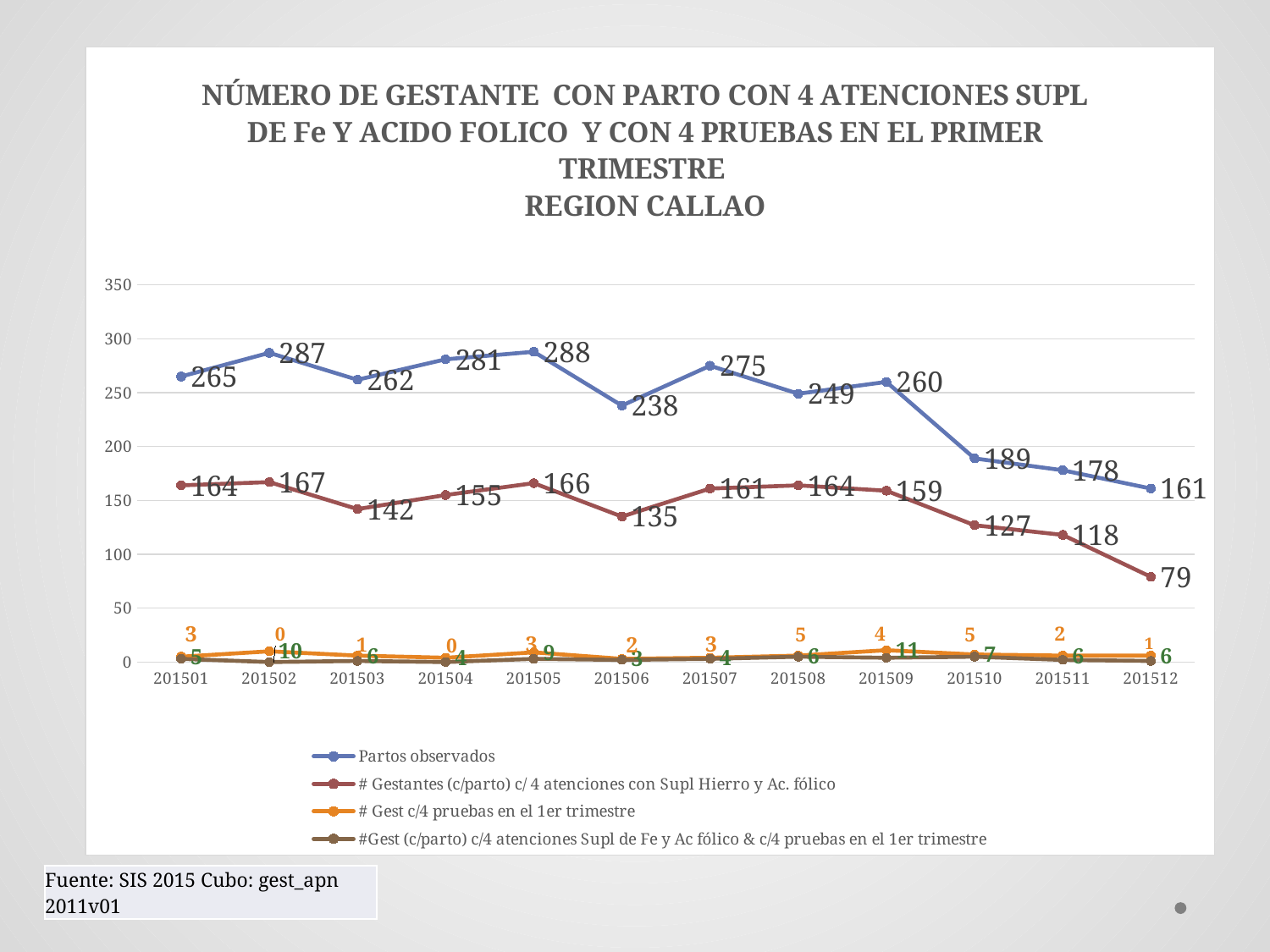
What is the value of Partos observados for 201505? 288 What is the difference between Partos observados in 201505 and in 201512? 127 What is the value of # Gestantes (c/parto) c/ 4 atenciones con Supl Hierro y Ac. fólico for 201512? 79 How many series does the legend list? 4 How many months are plotted along the x axis? 12 Does Partos observados rise or fall from 201509 to 201512? fall In which month is Partos observados highest? 201505 Which month has the larger value for Partos observados, 201507 or 201508? 201507 In which month is # Gestantes (c/parto) c/ 4 atenciones con Supl Hierro y Ac. fólico lowest? 201512 In which month is Partos observados lowest? 201512 What kind of chart is shown on the slide? line chart Is the value of Partos observados for 201506 greater or less than 250? less